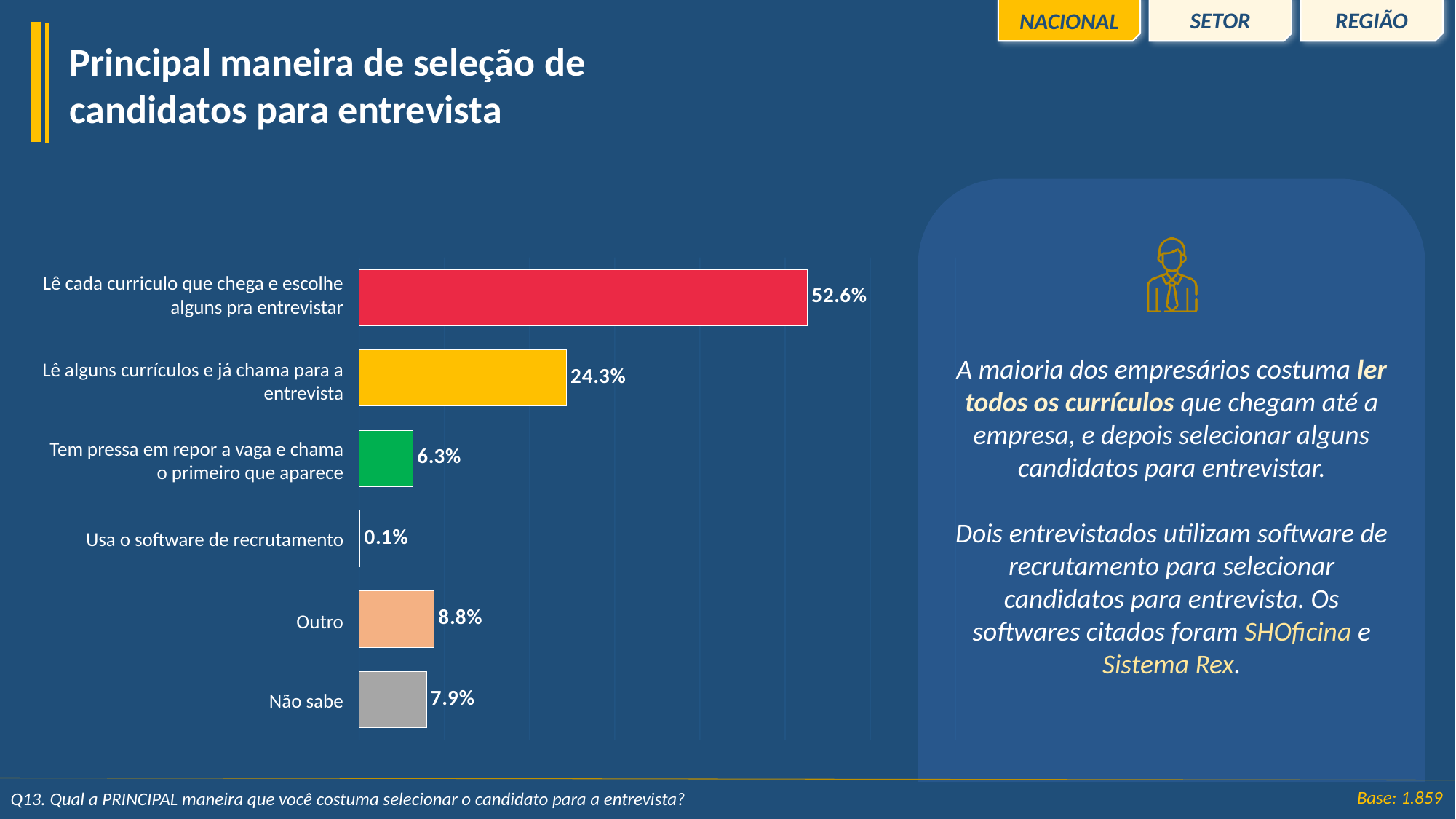
What is the difference between the values for "Lê cada curriculo que chega e escolhe alguns pra entrevistar" and "Lê alguns currículos e já chama para a entrevista"? 28.3% What is the difference between the values for "Outro" and "Tem pressa em repor a vaga e chama o primeiro que aparece"? 2.5% Which category has the highest value? Lê cada curriculo que chega e escolhe alguns pra entrevistar Which is larger, the value for "Outro" or the value for "Não sabe"? Outro What is the value for "Lê cada curriculo que chega e escolhe alguns pra entrevistar"? 52.6% What is the value for "Lê alguns currículos e já chama para a entrevista"? 24.3% What is the value for "Usa o software de recrutamento"? 0.1% What is the value for "Não sabe"? 7.9% What colour is the bar for "Tem pressa em repor a vaga e chama o primeiro que aparece"? Green What kind of chart is shown on the slide? Bar chart How many categories are shown in the chart? 6 Which category has the lowest value? Usa o software de recrutamento